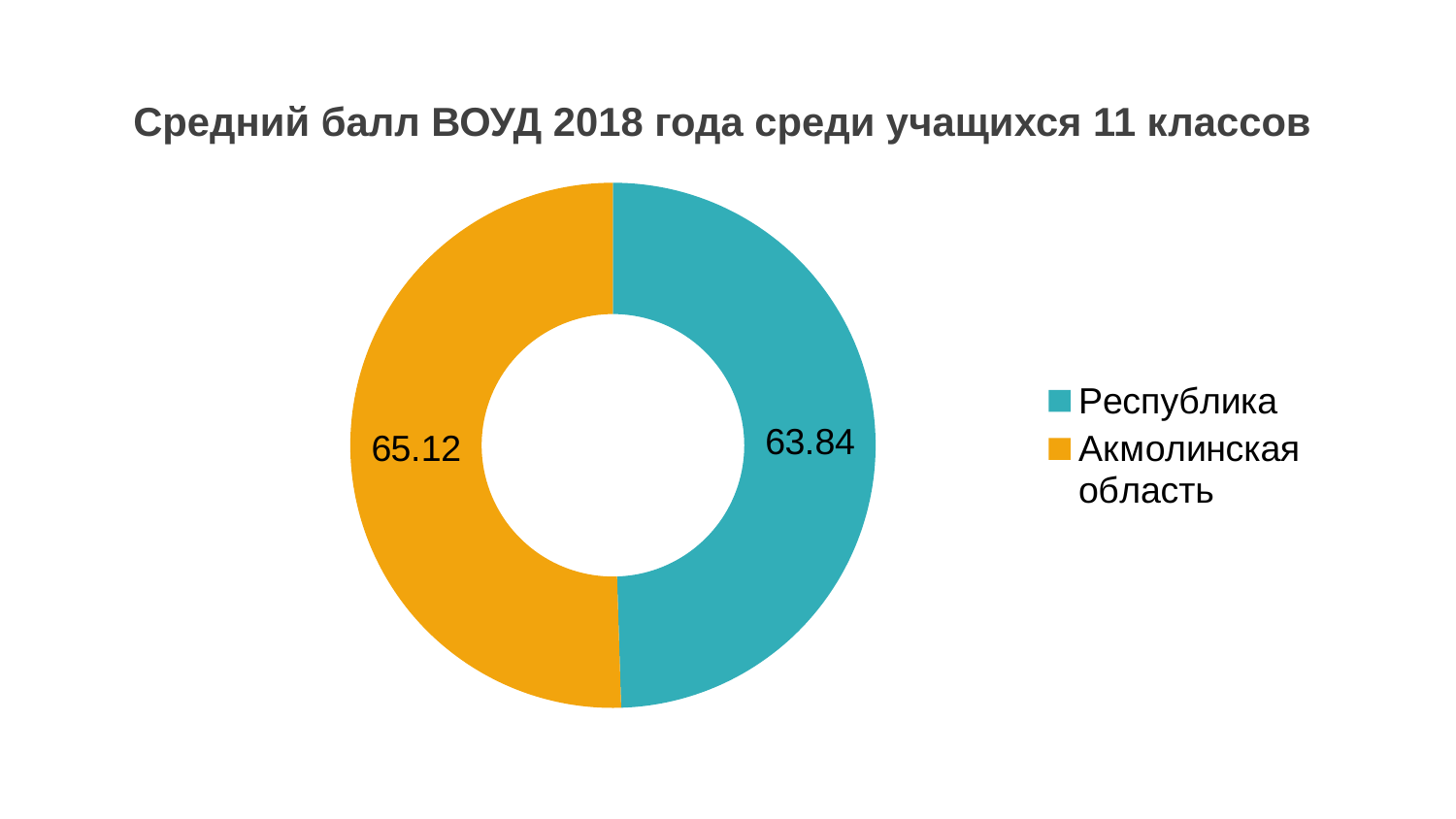
What is the difference between the values for Акмолинская область and Республика? 1.28 How many entries does the legend list? 2 Which category has the higher value? Акмолинская область Which colour represents Акмолинская область in the chart? orange Is the value for Республика larger or smaller than the value for Акмолинская область? smaller What kind of chart is shown on the slide? doughnut chart What is the value shown for Республика? 63.84 What is the value shown for Акмолинская область? 65.12 What is the title of the chart? Средний балл ВОУД 2018 года среди учащихся 11 классов How many categories are shown in the chart? 2 Which category has the lower value? Республика